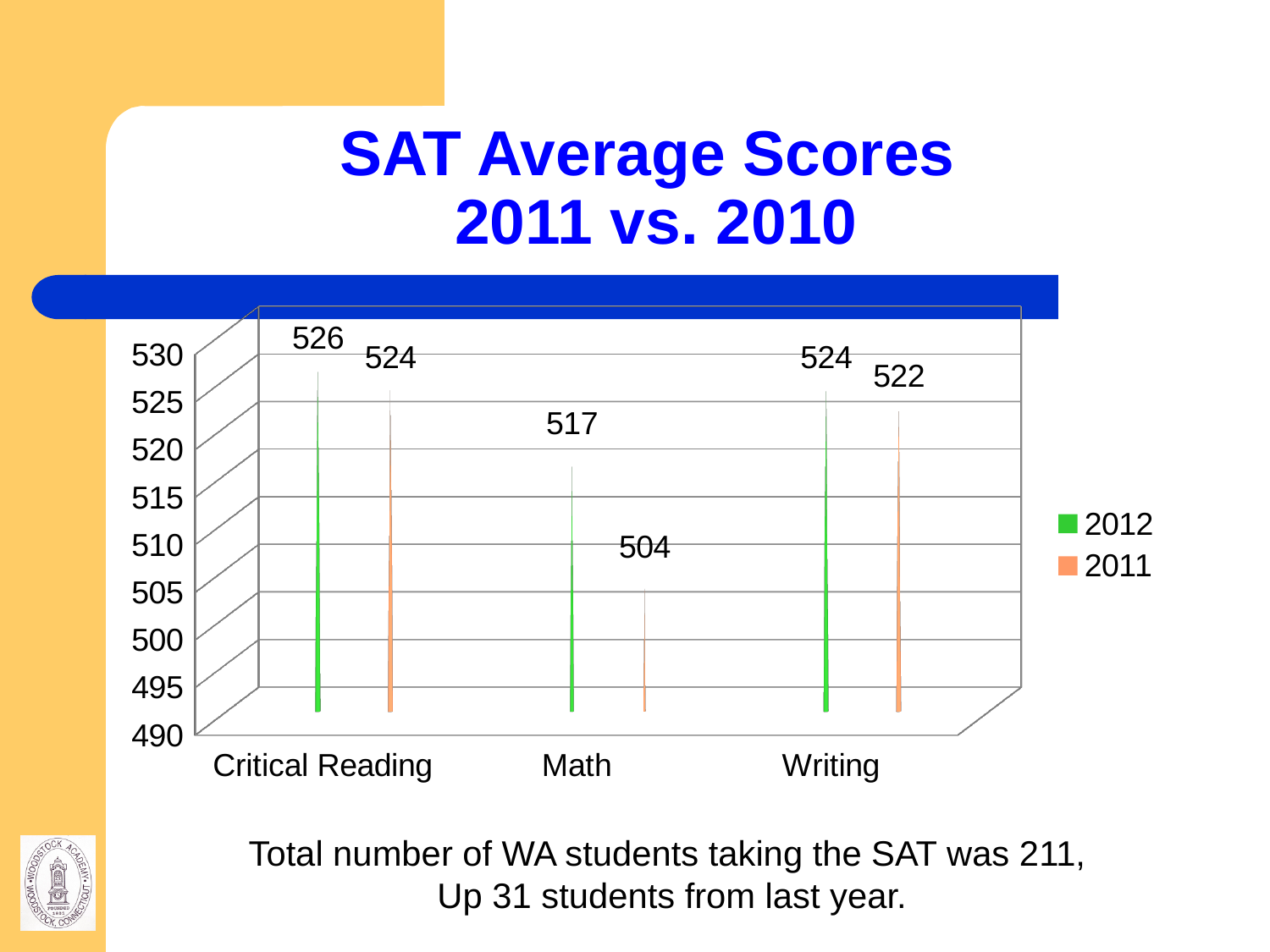
Which category has the highest 2012 score? Critical Reading What is the 2011 average score for Math? 504 What is the 2011 average score for Writing? 522 Which category has the lowest 2011 score? Math What is the difference between the 2012 and 2011 scores for Math? 13 What is the 2012 average score for Critical Reading? 526 Which is larger, the 2012 Math score or the 2011 Math score? 2012 Math score Is the 2011 value for Math greater or less than 510? less What kind of chart is shown on the slide? bar chart How many categories are shown on the x axis? 3 How many series does the legend list? 2 What is the difference between the 2012 Critical Reading score and the 2012 Writing score? 2